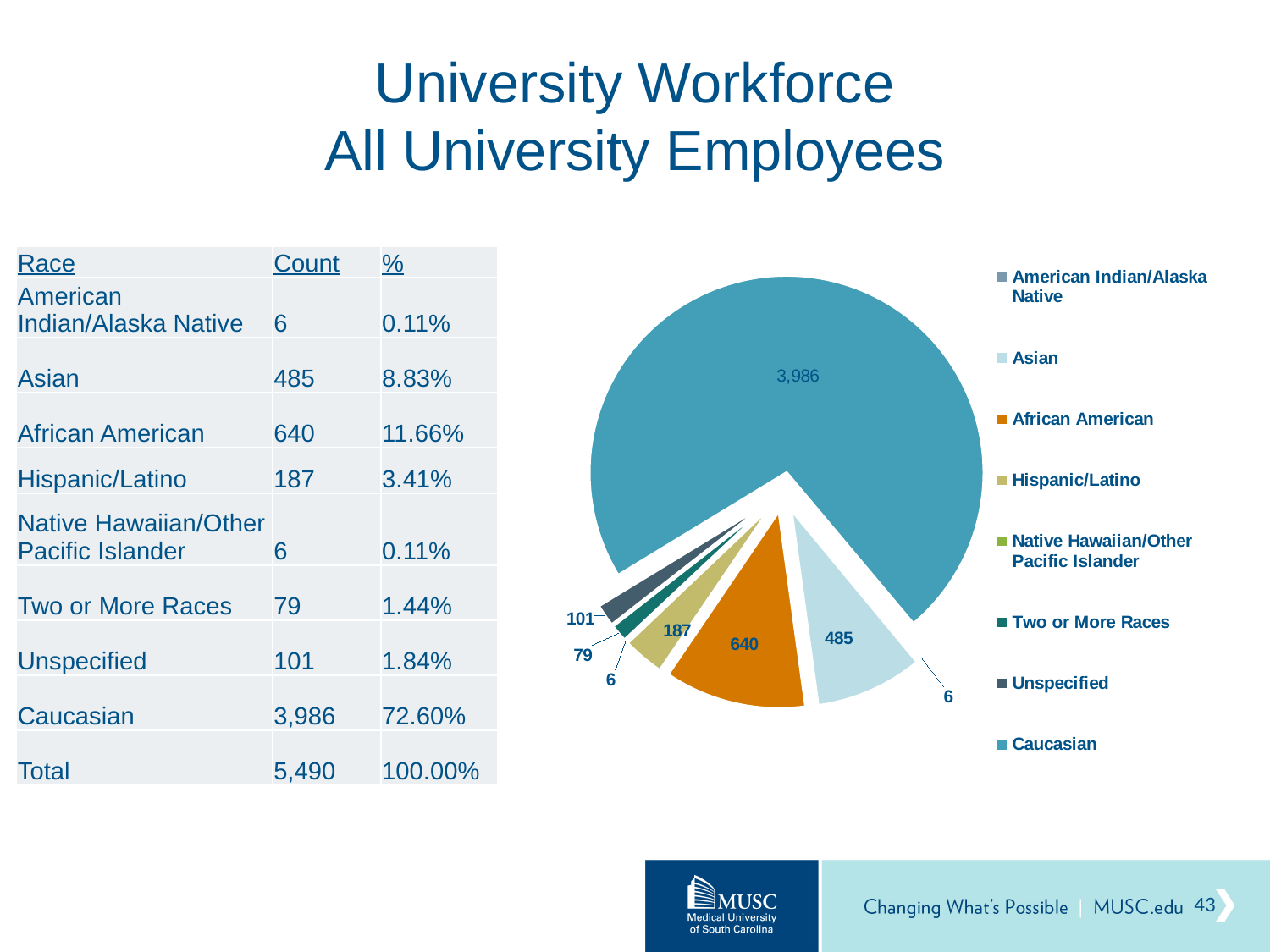
Which slice is larger in the pie chart, African American or Asian? African American What share of the pie does the Caucasian slice represent, according to the table on the slide? 72.60% What is the value of the Unspecified slice in the pie chart? 101 What is the difference between the Unspecified and Two or More Races values in the pie chart? 22 What is the value of the African American slice in the pie chart? 640 How many series does the legend of the pie chart list? 8 What is the value of the Hispanic/Latino slice in the pie chart? 187 What is the difference between the African American and Asian values in the pie chart? 155 What is the value of the Caucasian slice in the pie chart? 3,986 What kind of chart is shown on the slide? pie chart Which category has the largest slice in the pie chart? Caucasian What is the value of the Asian slice in the pie chart? 485